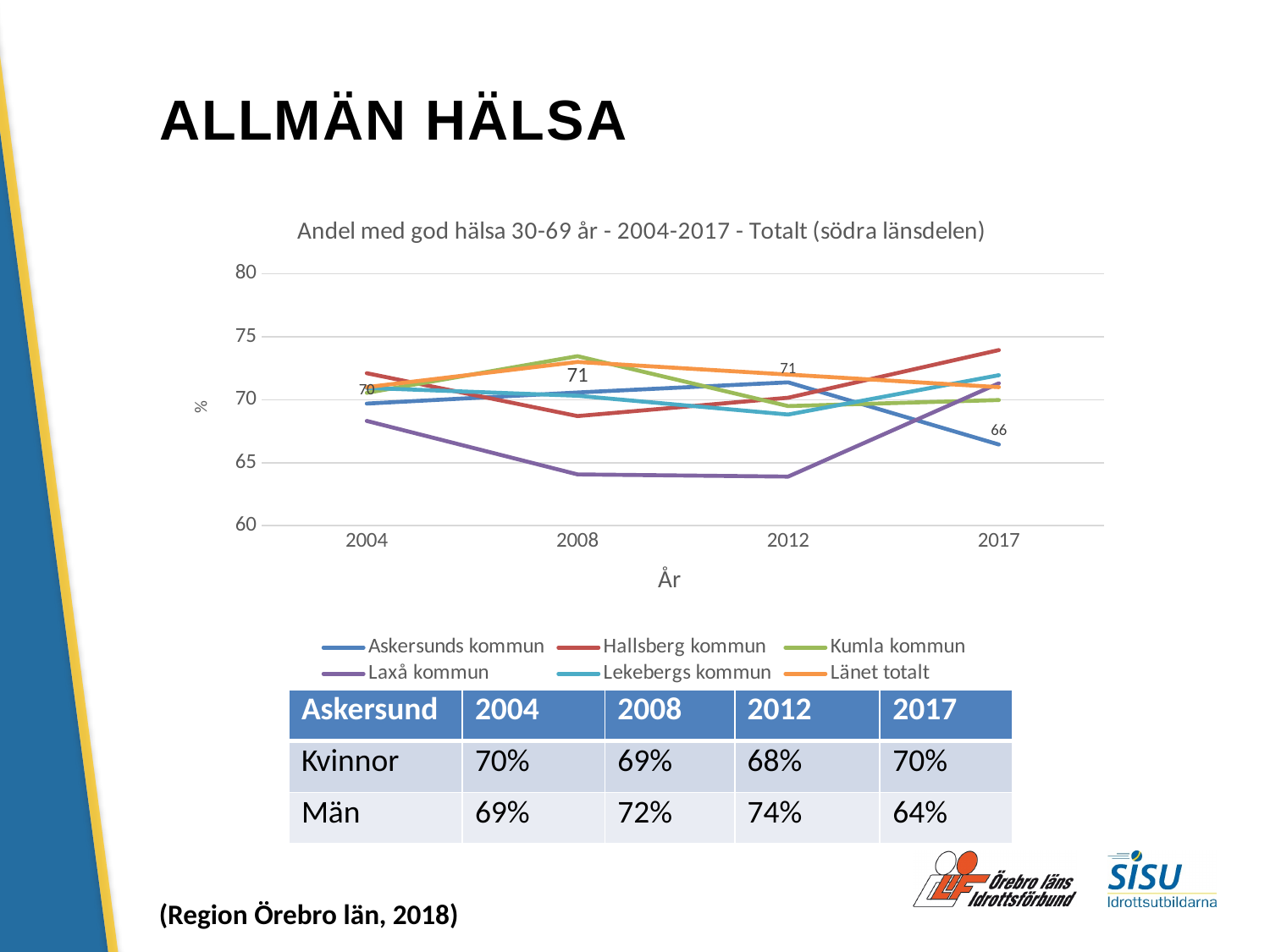
What is the labelled value for Askersunds kommun in 2004? 70 What type of chart is shown on the slide? line chart Is the value for Hallsberg kommun in 2017 greater or less than 70? greater How many series does the chart legend list? 6 How many years are plotted along the x axis of the chart? 4 What is the labelled value for Askersunds kommun in 2017? 66 Which series has the highest value in 2017? Hallsberg kommun What is the title of the chart? Andel med god hälsa 30-69 år - 2004-2017 - Totalt (södra länsdelen) What is the labelled value for Askersunds kommun in 2012? 71 Is the value for Laxå kommun in 2012 greater or less than 65? less By how much did the labelled value for Askersunds kommun fall from 2012 to 2017? 5 Which municipality has the lowest value in 2012? Laxå kommun